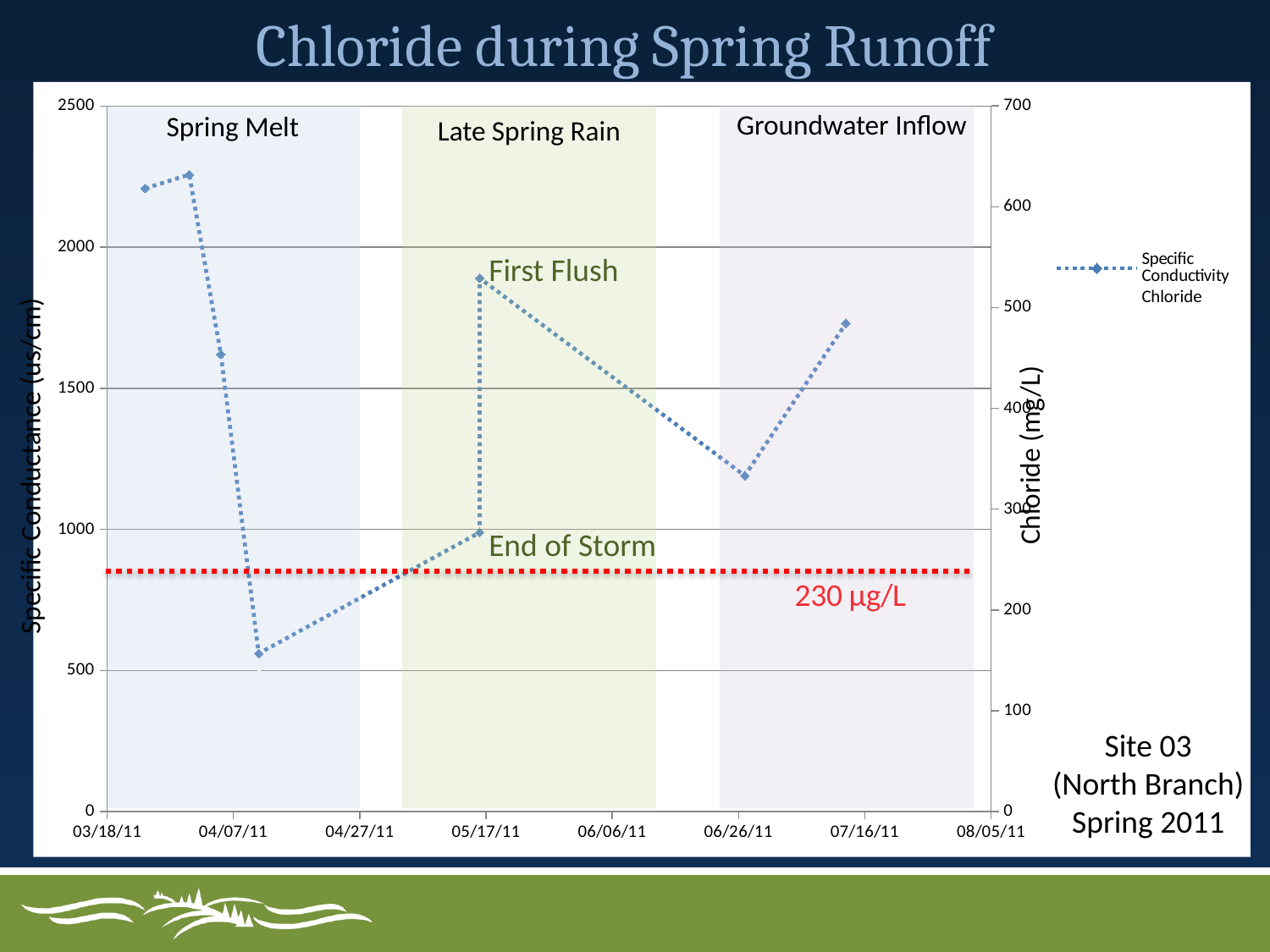
Which point has the larger value, the one labelled First Flush or the one labelled End of Storm? First Flush Do the plotted values rise or fall across the Spring Melt period? fall Is the plotted value at 06/26/11 greater or less than 1500 on the left axis? less How many series does the legend list? 2 Is the first plotted value (just after 03/18/11) greater or less than 2000 on the left axis? greater How many data points are plotted on the Specific Conductivity line? 8 What is the title of the chart? Chloride during Spring Runoff Is the lowest plotted value in the Spring Melt period greater or less than 1000 on the left axis? less What kind of chart is shown on the slide? line chart In which shaded period does the highest plotted value occur? Spring Melt In which shaded period does the lowest plotted value occur? Spring Melt What value is labelled on the red dashed horizontal line? 230 µg/L